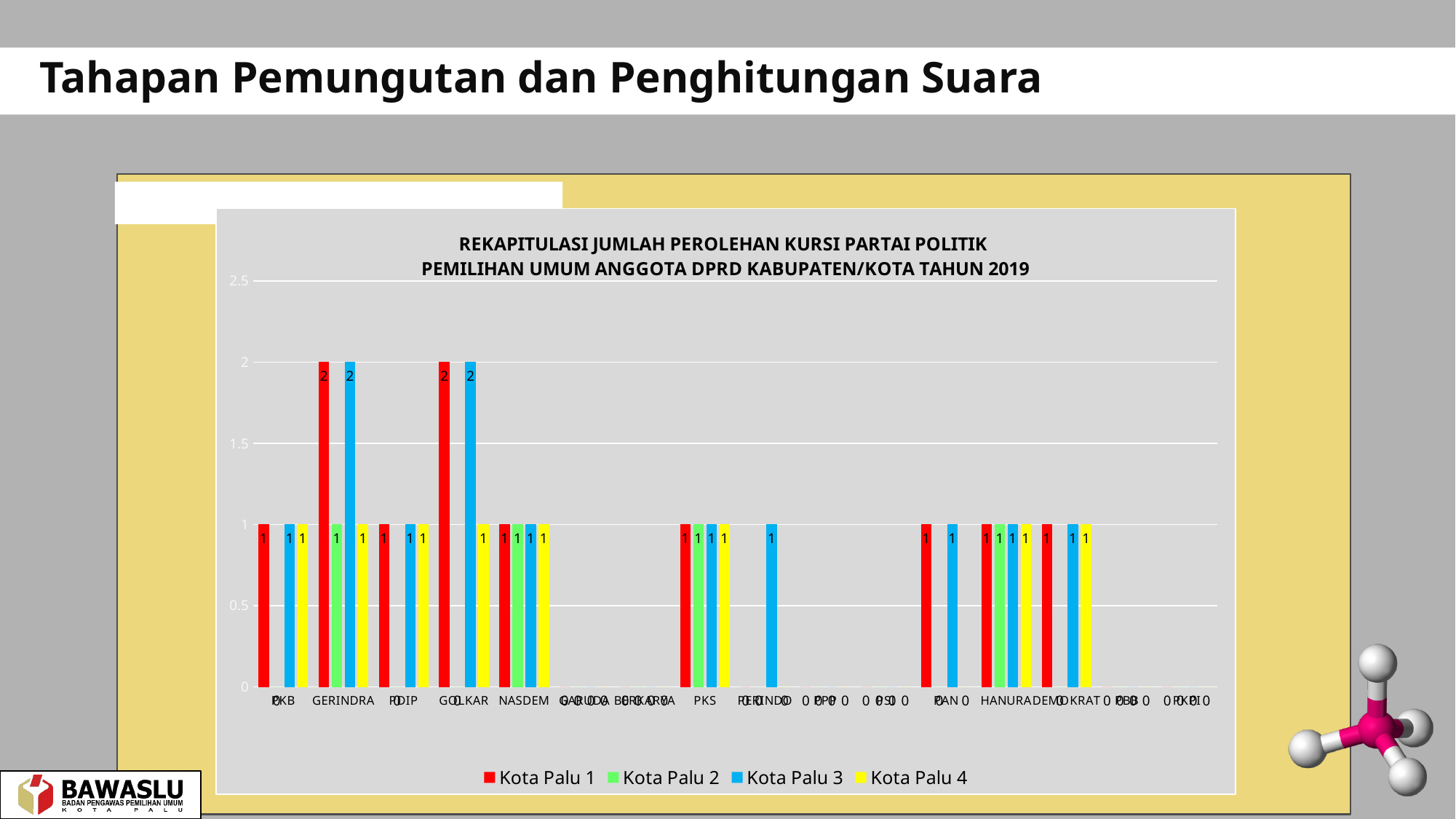
For GOLKAR, which is larger: Kota Palu 1 or Kota Palu 4? Kota Palu 1 What kind of chart is shown on the slide? bar chart What is the value for Kota Palu 1 for HANURA? 1 What is the difference between Kota Palu 1 and Kota Palu 2 for GERINDRA? 1 What is the value for Kota Palu 1 for GERINDRA? 2 What is the highest value plotted on the chart? 2 What colour represents Kota Palu 3 in the legend? blue What is the value for Kota Palu 2 for NASDEM? 1 How many series does the legend list? 4 Which has the larger Kota Palu 1 value: PKB or GERINDRA? GERINDRA What is the value for Kota Palu 4 for GERINDRA? 1 What is the value for Kota Palu 3 for GOLKAR? 2